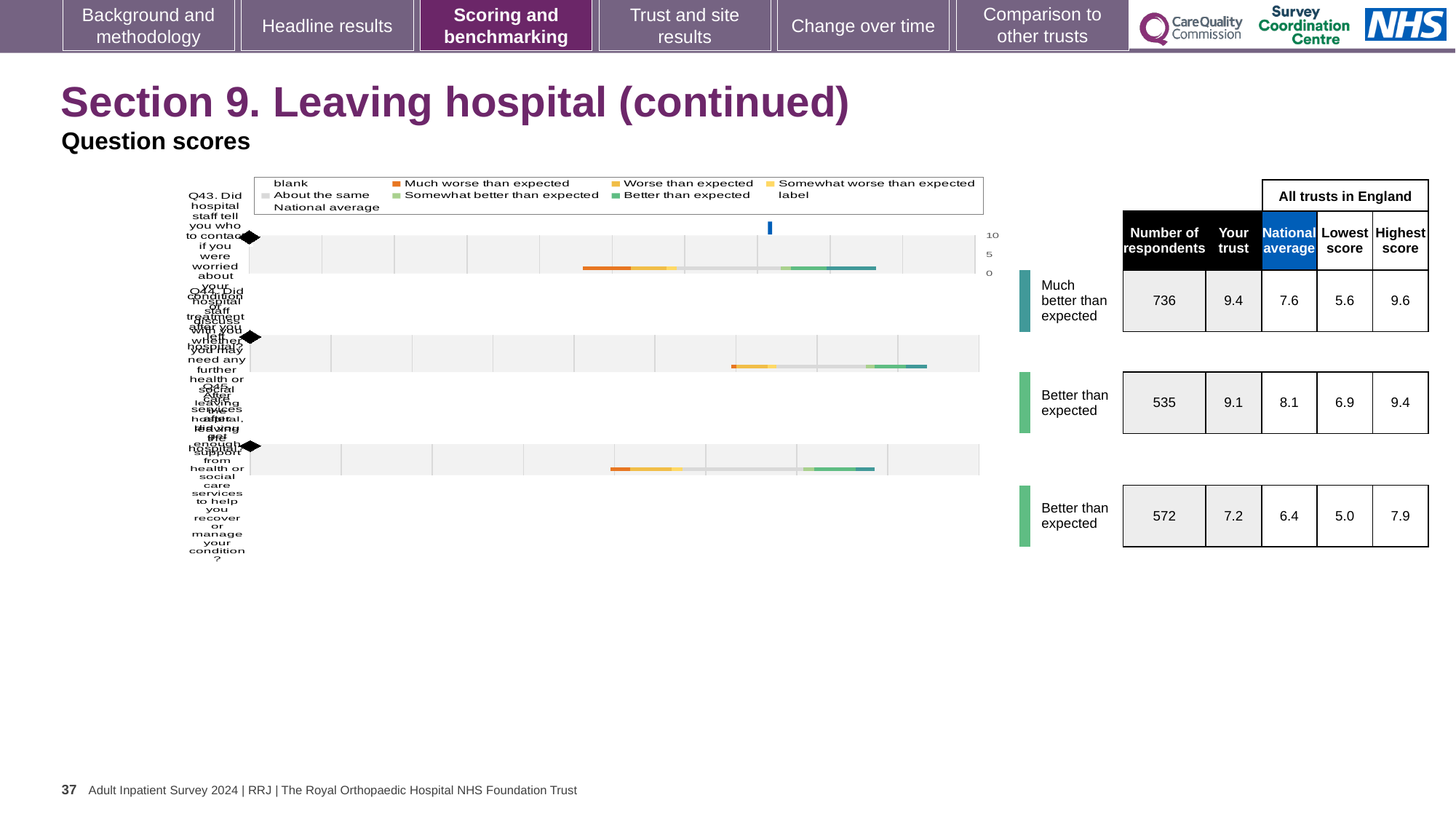
How many question rows are shown on the slide? 3 What is the lowest score among all trusts in England for Q45 (the third question row)? 5.0 What is the national average score for Q44 (the second question row)? 8.1 For Q44 (the second question row), which is larger: the 'Your trust' score or the national average? Your trust (9.1) What is the 'Your trust' score for Q43 (the first question row)? 9.4 For Q43 (the first question row), how much higher is the 'Your trust' score than the national average? 1.8 What kind of chart is used to show the question scores? Bar chart Which question row has the lowest 'Your trust' score? Q45 (7.2) How many respondents answered Q45 (the third question row)? 572 What is the highest score among all trusts in England for Q43 (the first question row)? 9.6 What benchmark rating is shown for Q43 (the first question row)? Much better than expected Which question row has the highest 'Your trust' score? Q43 (9.4)